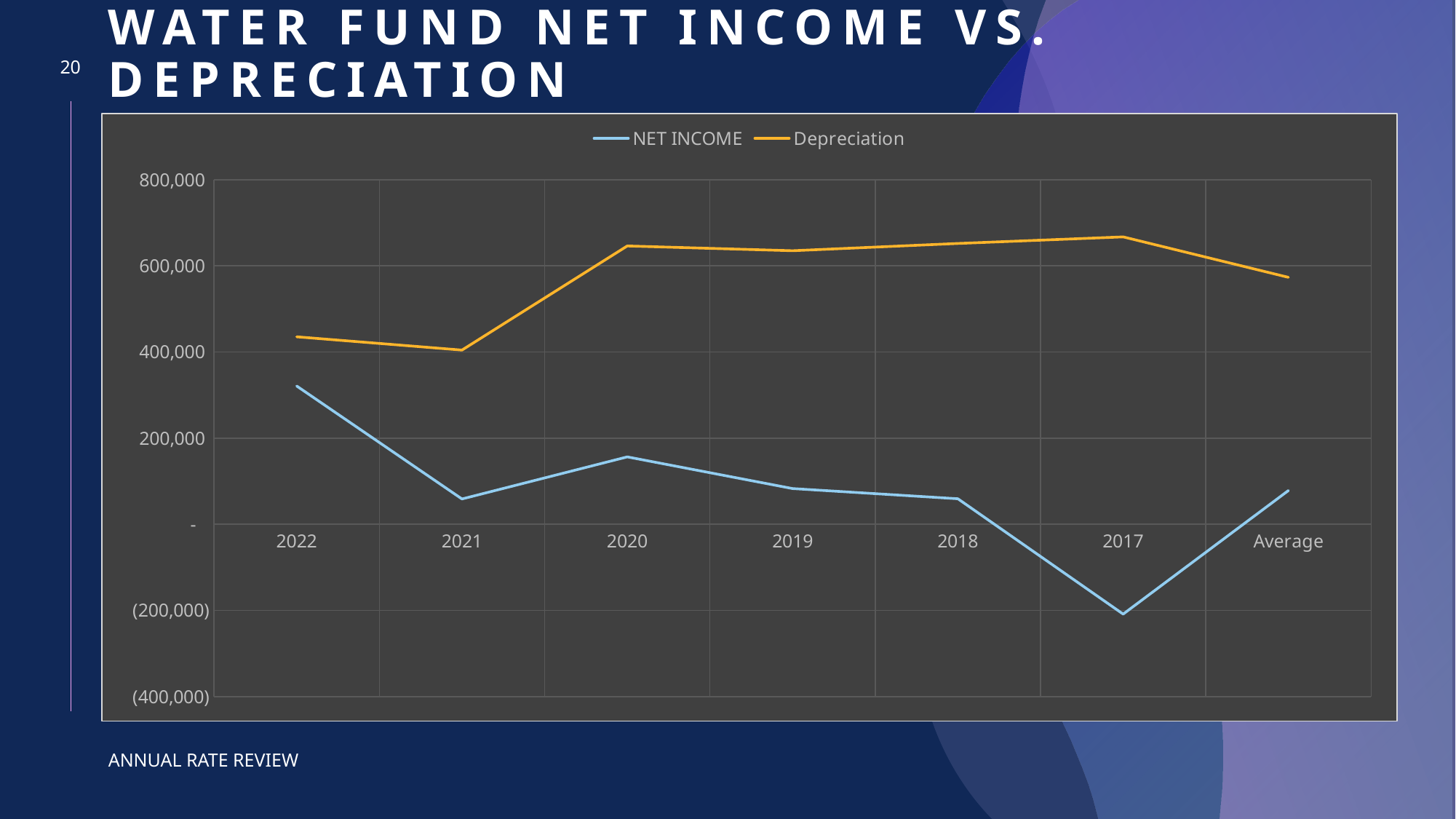
In which year is NET INCOME lowest? 2017 In which year is Depreciation lowest? 2021 Is the Depreciation value for 2022 greater or less than 400,000? greater Is the NET INCOME value for 2021 greater or less than 200,000? less Which series is drawn in orange? Depreciation In which year is NET INCOME highest? 2022 How many series does the legend list? 2 In which year is Depreciation highest? 2017 How many categories are shown on the x axis? 7 What kind of chart is shown on the slide? line chart For 2022, which is larger, NET INCOME or Depreciation? Depreciation Is the Depreciation value for 2020 greater or less than 600,000? greater